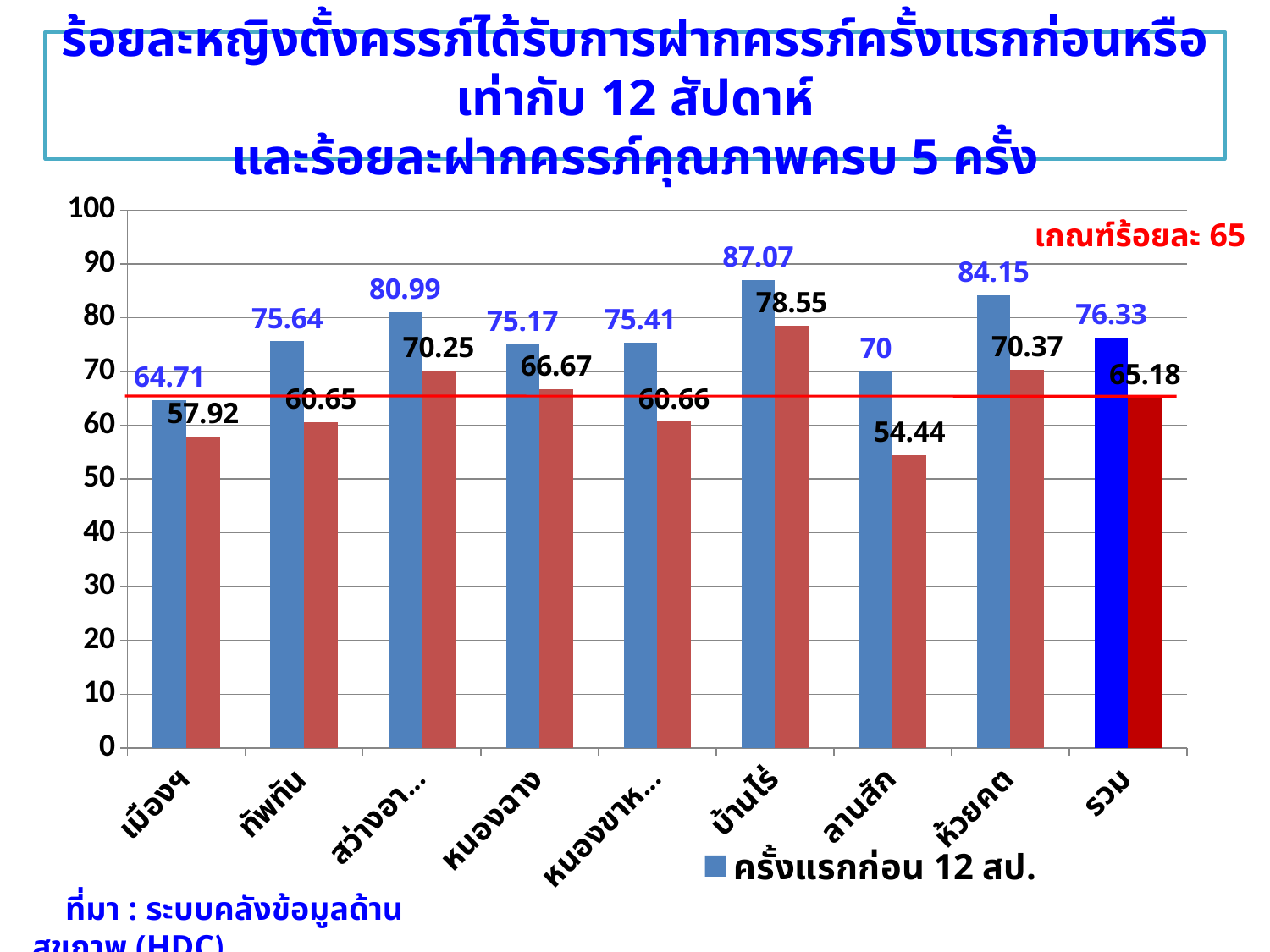
How many categories are shown along the x axis of the chart? 9 What is the value of the red bar for ลานสัก? 54.44 What is the value of the blue bar (ครั้งแรกก่อน 12 สป.) for บ้านไร่? 87.07 What is the difference between the blue bar and the red bar for บ้านไร่? 8.52 Which category has the lowest value for the blue series (ครั้งแรกก่อน 12 สป.)? เมืองฯ What is the value of the red bar for รวม? 65.18 Which category has the highest value for the blue series (ครั้งแรกก่อน 12 สป.)? บ้านไร่ What is the value of the blue bar (ครั้งแรกก่อน 12 สป.) for ห้วยคต? 84.15 Which category has the lowest value for the red series? ลานสัก Which is larger: the blue bar for สว่างอา... or the blue bar for ทัพทัน? สว่างอา... What type of chart is shown on the slide? bar chart What threshold value does the red horizontal line on the chart represent? เกณฑ์ร้อยละ 65